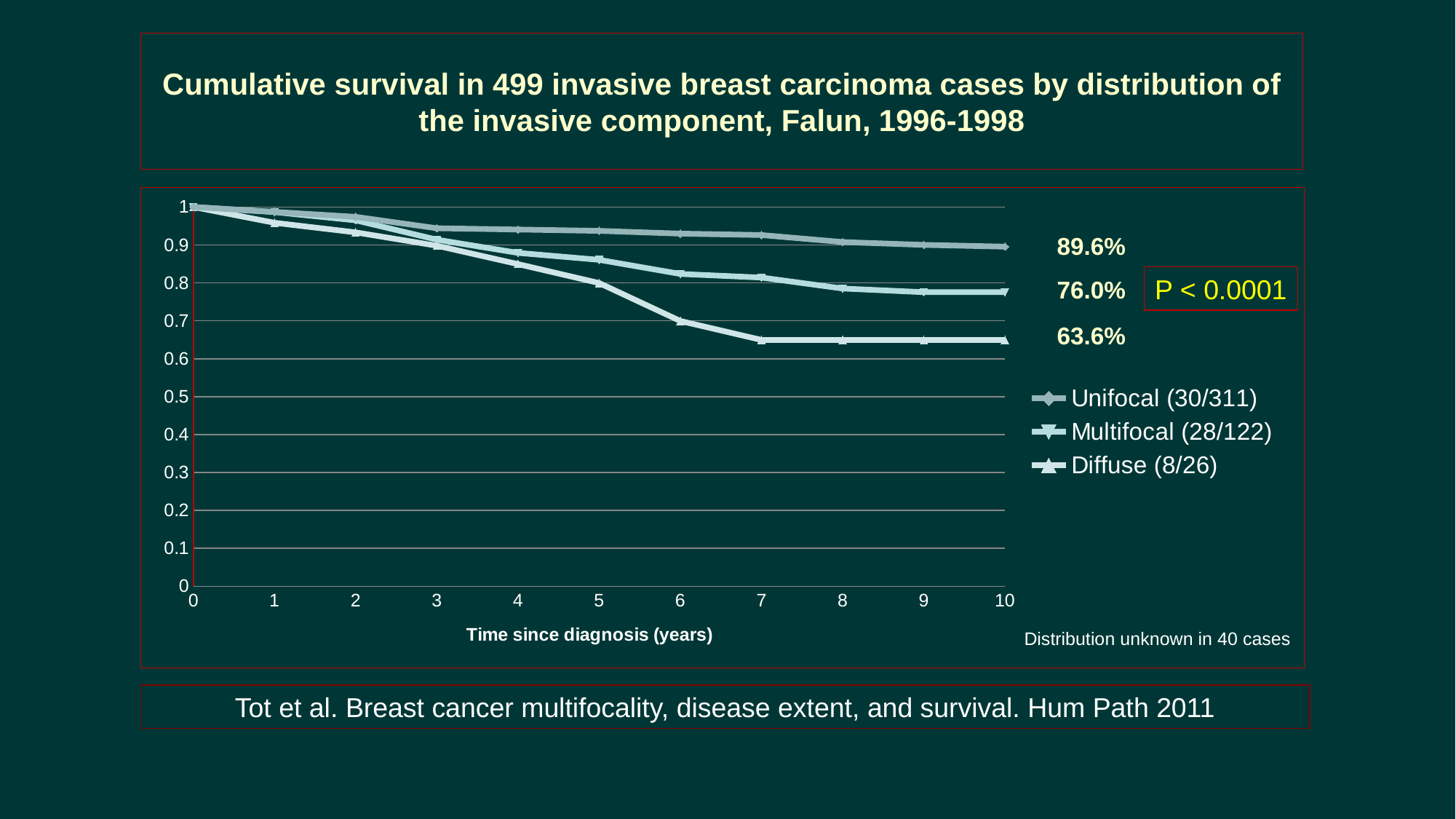
What is the cumulative survival labelled at the end of the Unifocal (30/311) line? 89.6% What is the cumulative survival labelled at the end of the Multifocal (28/122) line? 76.0% Which group has the lowest cumulative survival at 10 years? Diffuse (8/26) How many series does the legend list? 3 What is the title of the x axis? Time since diagnosis (years) Is the value for the Diffuse (8/26) line at 7 years greater or less than 0.7? less What is the cumulative survival labelled at the end of the Diffuse (8/26) line? 63.6% Do the survival curves rise or fall as time since diagnosis increases? Fall Is the value for the Unifocal (30/311) line at 5 years greater or less than 0.9? greater What kind of chart is shown on the slide? Line chart What is the difference between the final survival values of the Unifocal and Diffuse groups? 26.0 percentage points Which group has the highest cumulative survival at 10 years? Unifocal (30/311)